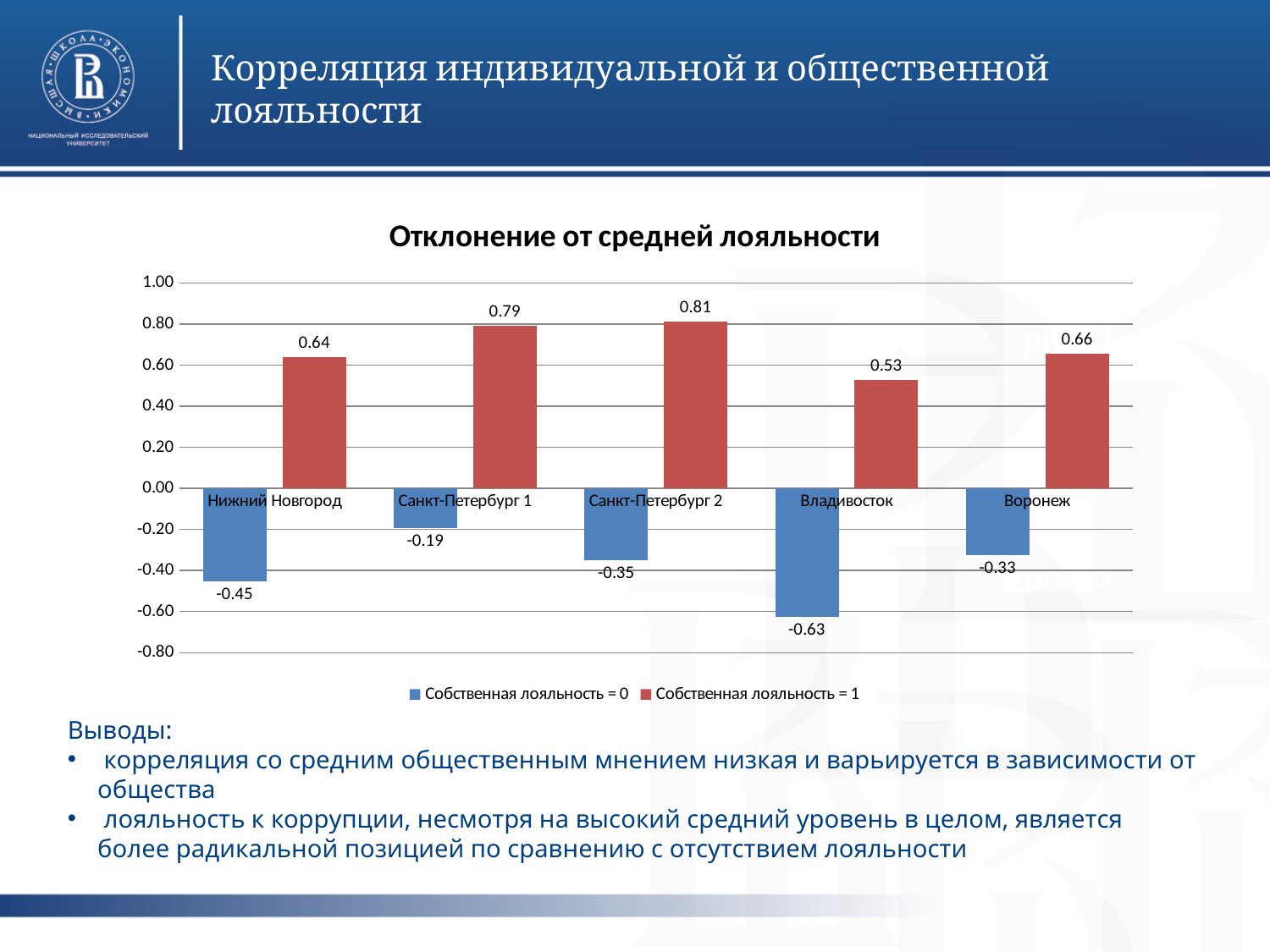
Which category has the lowest value in the series "Собственная лояльность = 0"? Владивосток Which is larger in the series "Собственная лояльность = 1": Воронеж or Владивосток? Воронеж How many categories are shown on the x axis? 5 How many series does the legend list? 2 What is the difference between the "Собственная лояльность = 1" values for Санкт-Петербург 1 and Нижний Новгород? 0.15 What is the title of the chart? Отклонение от средней лояльности What is the value for Санкт-Петербург 1 in the series "Собственная лояльность = 0"? -0.19 What is the value for Владивосток in the series "Собственная лояльность = 1"? 0.53 Is the value for Санкт-Петербург 2 in the series "Собственная лояльность = 1" greater or less than 0.80? greater What is the value for Нижний Новгород in the series "Собственная лояльность = 0"? -0.45 What kind of chart is shown on the slide? Bar chart Which category has the highest value in the series "Собственная лояльность = 1"? Санкт-Петербург 2